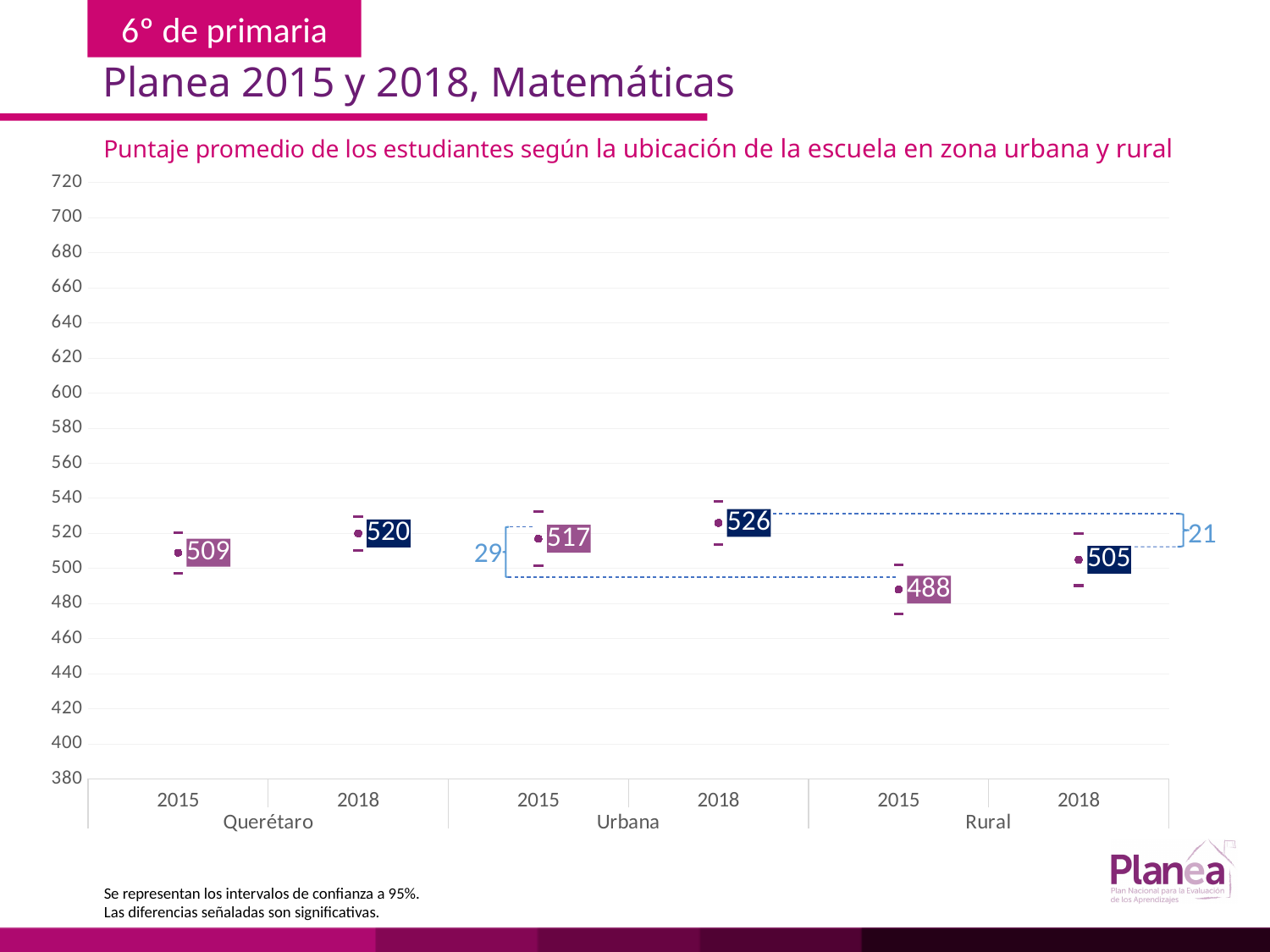
Which is larger, the Rural score in 2018 or the Querétaro score in 2015? Querétaro 2015 Which group and year has the highest average score? Urbana 2018 What is the average score for Rural schools in 2018? 505 What is the average score for Urbana schools in 2015? 517 What is the difference between the Urbana and Rural average scores in 2015? 29 What is the average score for Querétaro in 2018? 520 Which group and year has the lowest average score? Rural 2015 What is the difference between the Urbana and Rural average scores in 2018? 21 How many data points are plotted on the chart? 6 What is the average score for Rural schools in 2015? 488 What is the average score for Urbana schools in 2018? 526 What is the average score for Querétaro in 2015? 509